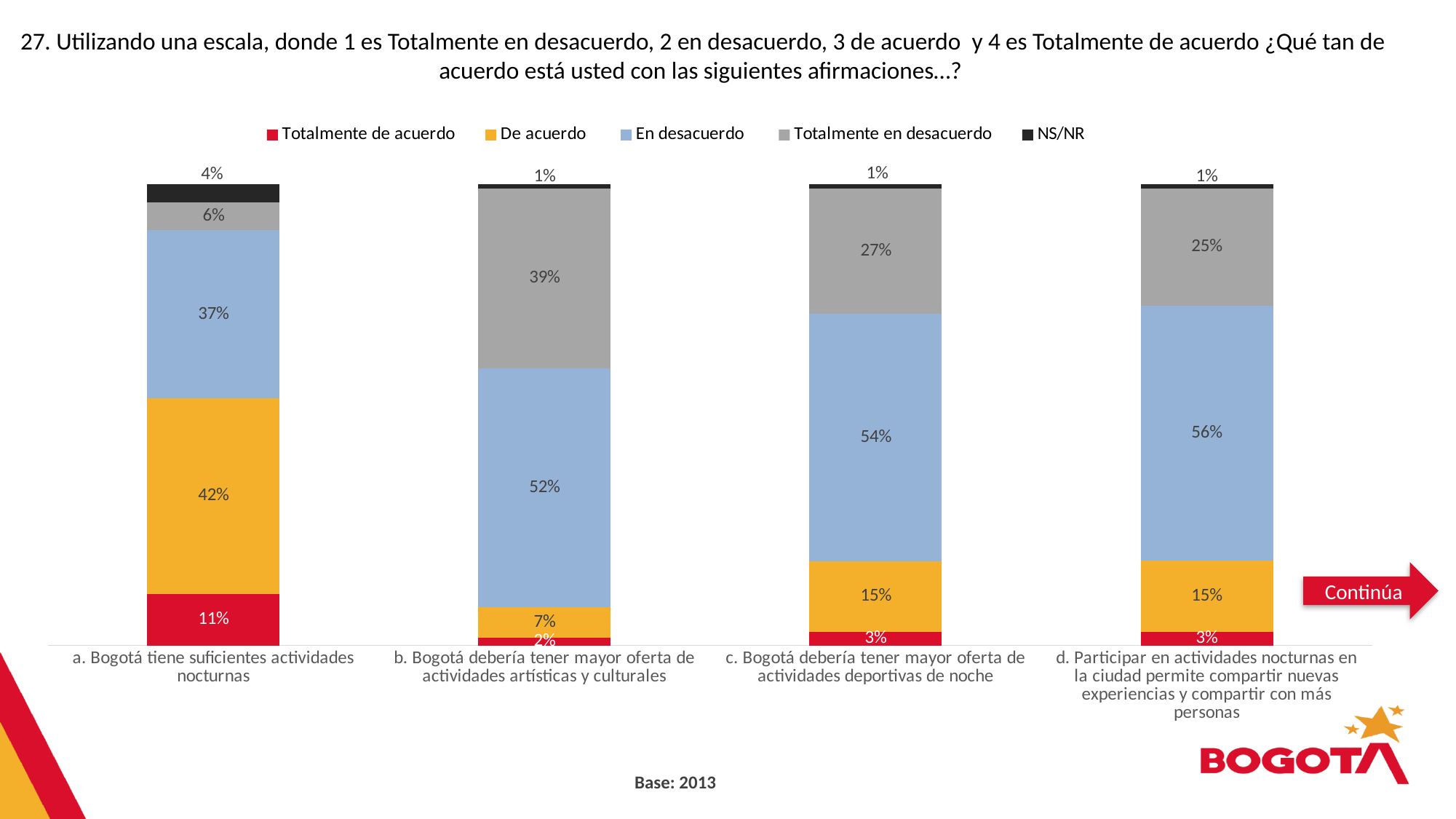
Which statement has the highest "Totalmente de acuerdo" value? a. Bogotá tiene suficientes actividades nocturnas What percentage of respondents answered "De acuerdo" for statement a (Bogotá tiene suficientes actividades nocturnas)? 42% What is the difference between the "En desacuerdo" values for statement c and statement a? 17% Which is larger: the "Totalmente en desacuerdo" value for statement c or for statement d? statement c (27%) What is the "En desacuerdo" value for statement d (Participar en actividades nocturnas en la ciudad permite compartir nuevas experiencias)? 56% Which statement has the lowest "Totalmente en desacuerdo" value? a. Bogotá tiene suficientes actividades nocturnas What is the combined "Totalmente de acuerdo" and "De acuerdo" share for statement c? 18% What is the "Totalmente en desacuerdo" value for statement b (Bogotá debería tener mayor oferta de actividades artísticas y culturales)? 39% What kind of chart is shown on the slide? stacked bar chart How many statements (categories) are shown on the x axis? 4 What is the NS/NR value for statement a? 4% How many series does the legend list? 5